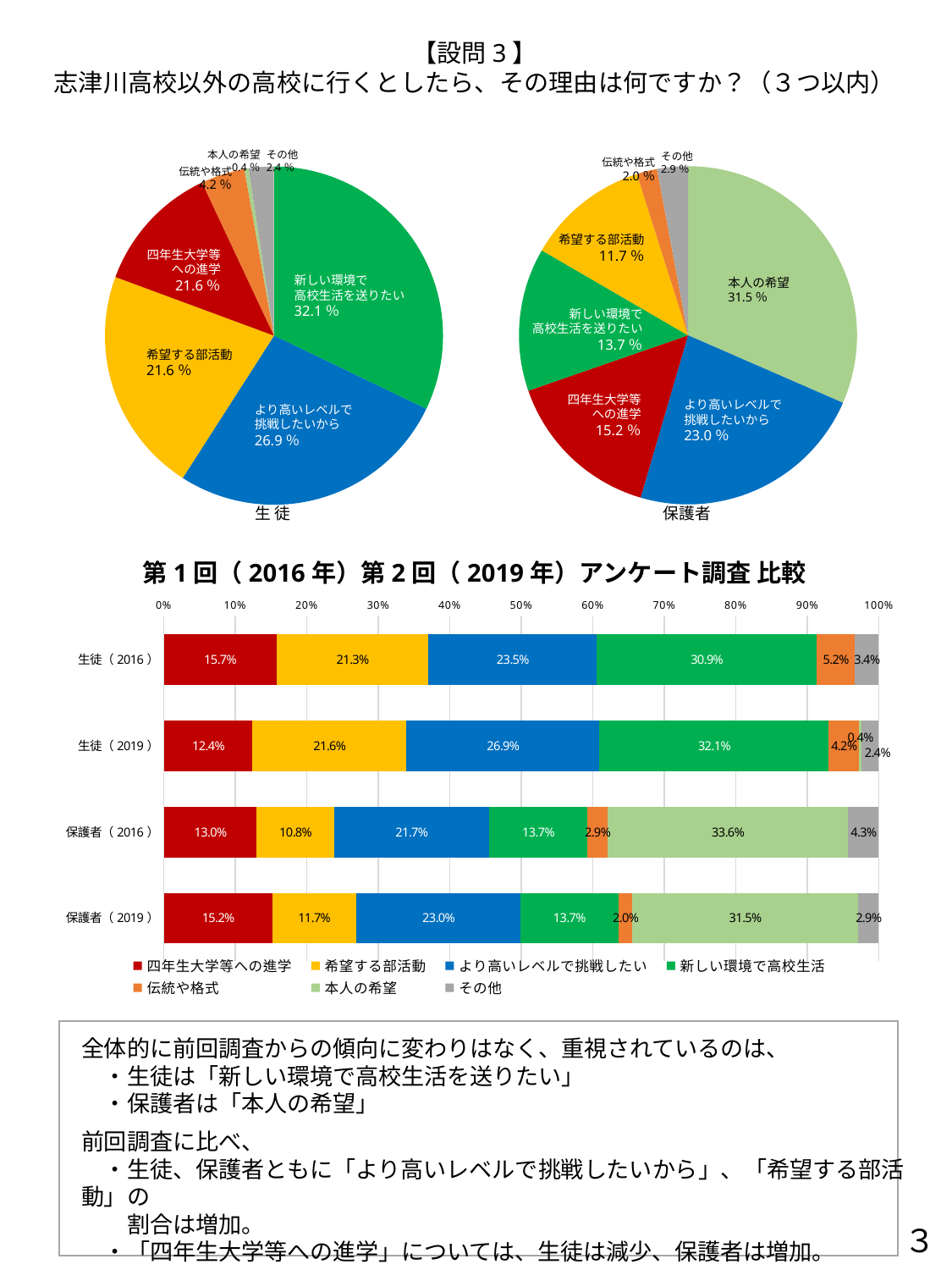
In the 生徒 pie chart (top left), what is the share for より高いレベルで挑戦したいから? 26.9 % In the 保護者 pie chart (top right), what is the share for 本人の希望? 31.5 % How many series does the legend of the bottom comparison chart list? 7 In the bottom comparison chart, what is the difference between the 新しい環境で高校生活 values for 生徒（2019） and 生徒（2016）? 1.2% In the bottom comparison chart, is the 四年生大学等への進学 value larger for 保護者（2019） or 保護者（2016）? 保護者（2019） In the 保護者 pie chart (top right), which is larger: 四年生大学等への進学 or 希望する部活動? 四年生大学等への進学 What kind of chart is the bottom comparison chart? Stacked bar chart In the bottom comparison chart, what is the value for 本人の希望 in the 保護者（2016） bar? 33.6% In the 生徒 pie chart (top left), which category has the largest share? 新しい環境で高校生活を送りたい How many bars are there in the bottom comparison chart? 4 In the 保護者 pie chart (top right), which category has the smallest share? 伝統や格式 In the bottom comparison chart (第1回（2016年）第2回（2019年）アンケート調査 比較), what is the value for 希望する部活動 in the 生徒（2016） bar? 21.3%